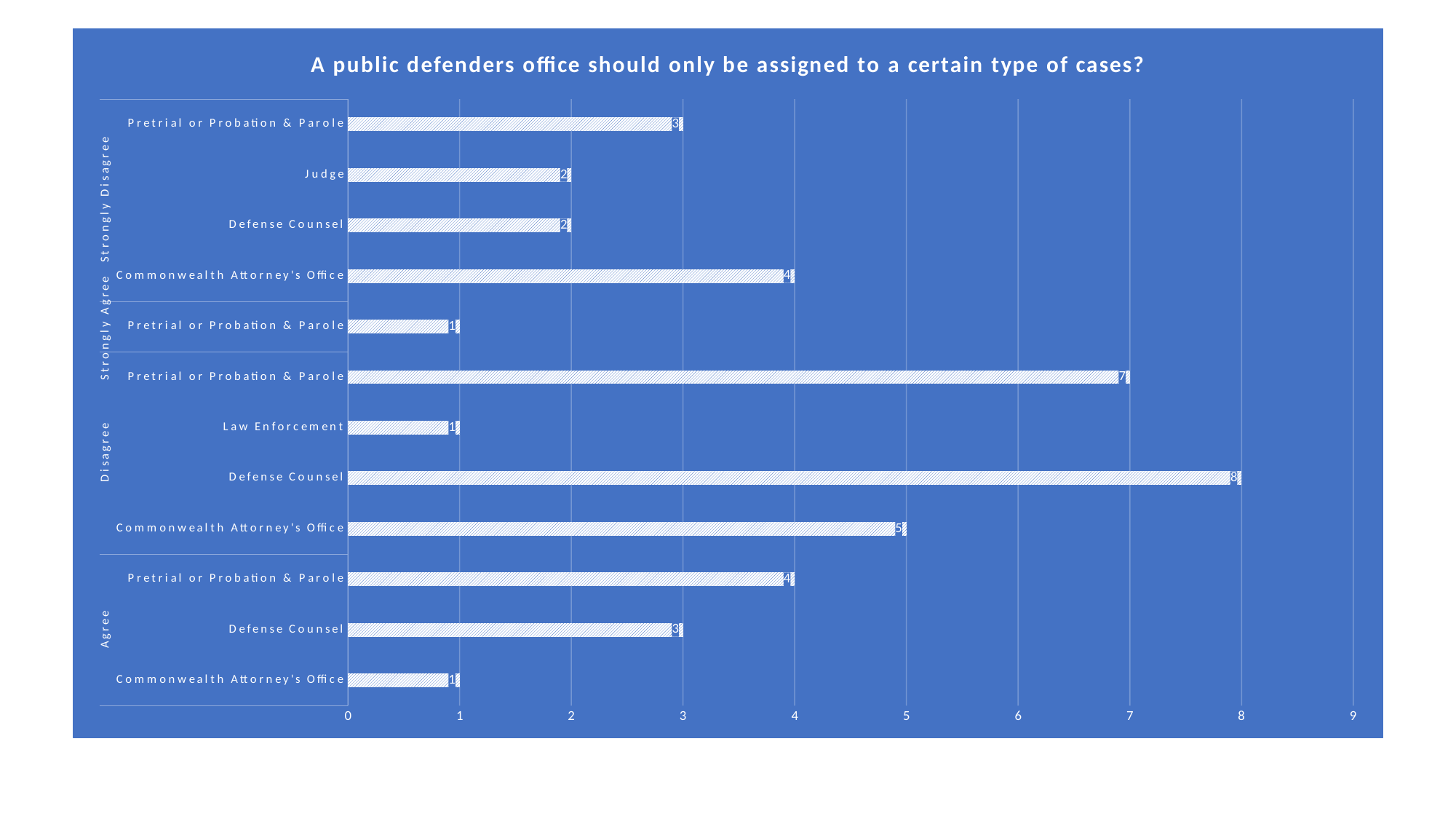
What is the title of the chart? A public defenders office should only be assigned to a certain type of cases? What is the value for Pretrial or Probation & Parole in the Strongly Agree group? 1 What is the value for Law Enforcement in the Disagree group? 1 What is the value for Judge in the Strongly Disagree group? 2 What kind of chart is shown on the slide? bar chart What is the total of the three bars in the Agree group? 8 What is the value for Commonwealth Attorney's Office in the Strongly Disagree group? 4 How many bars are plotted on the chart? 12 What is the difference between Pretrial or Probation & Parole in the Disagree group and Pretrial or Probation & Parole in the Agree group? 3 Which bar has the highest value on the chart? Defense Counsel (Disagree) Which is larger: Commonwealth Attorney's Office in the Disagree group or Commonwealth Attorney's Office in the Agree group? Commonwealth Attorney's Office in the Disagree group What is the value for Defense Counsel in the Disagree group? 8